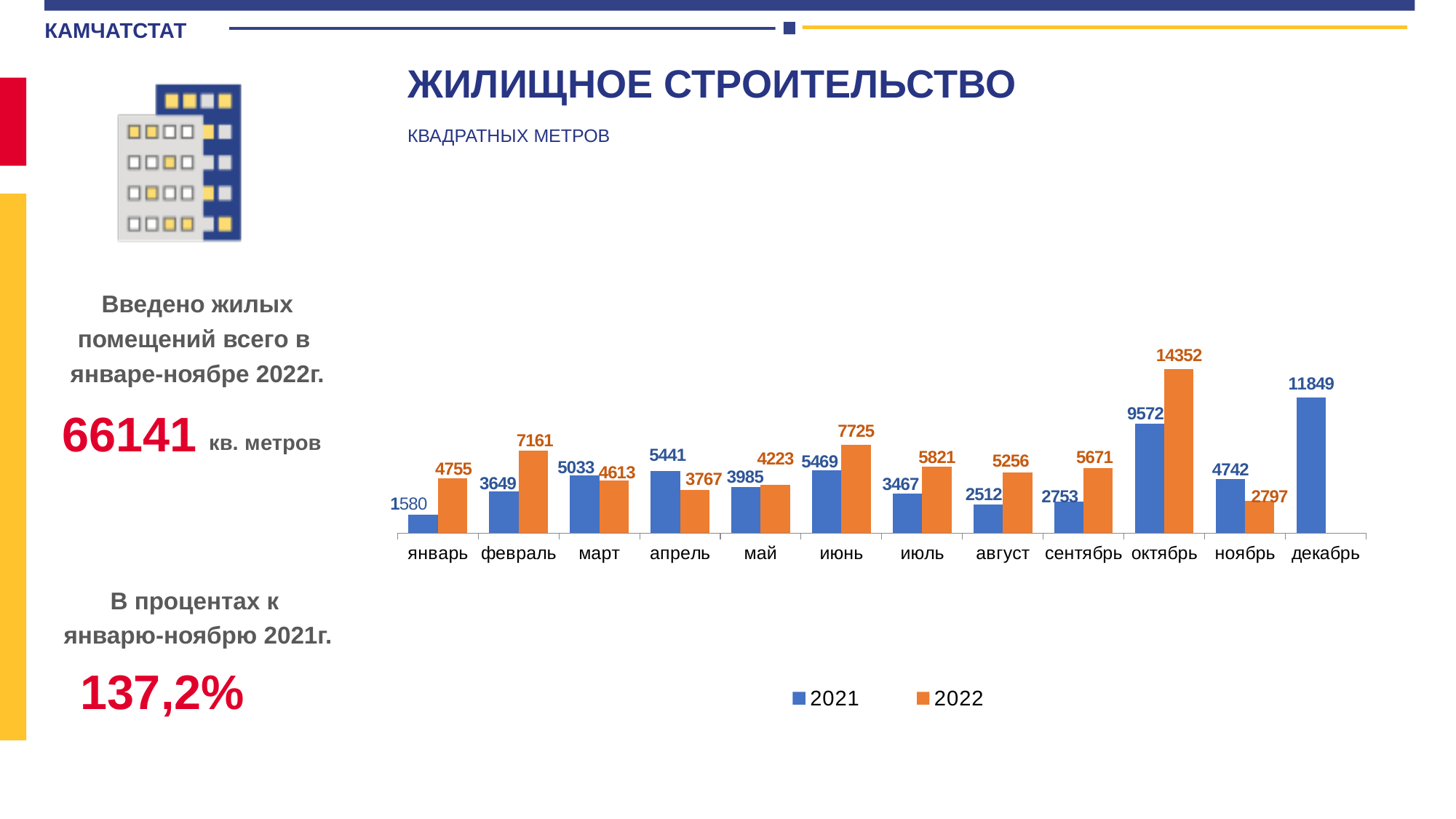
What is the value for 2022 in октябрь? 14352 What is the difference between the 2022 and 2021 values in октябрь? 4780 Which is larger in март: the 2021 value or the 2022 value? 2021 What type of chart is shown on the slide? bar chart Which month has the highest value for the 2022 series? октябрь How many months are shown on the x axis of the chart? 12 Which month has the lowest value for the 2021 series? январь How many series does the chart legend list? 2 What is the value for 2021 in январь? 1580 Which series is shown in orange in the chart legend? 2022 What is the value for 2022 in ноябрь? 2797 What is the value for 2021 in декабрь? 11849